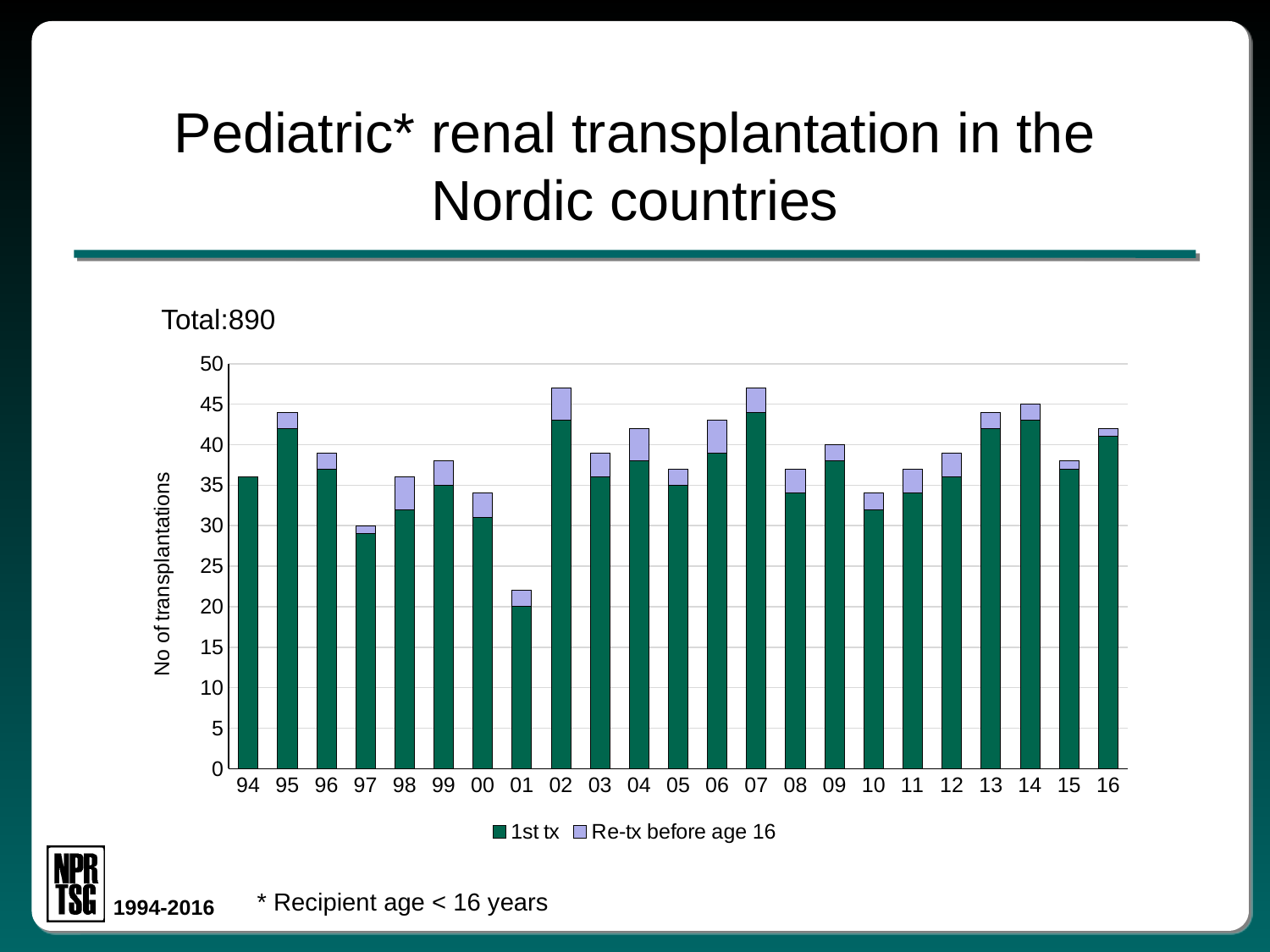
What are the two series named in the legend? 1st tx and Re-tx before age 16 Which year has the lowest total number of transplantations? 01 What total number of transplantations is printed above the chart? Total:890 Is the total value for 01 greater or less than 25? less Is the total value for 02 greater or less than 45? greater Is the total value for 16 greater or less than 40? greater What kind of chart is shown on the slide? bar chart How many series does the legend list? 2 How many years (categories) are shown on the x axis? 23 Which year has the larger total number of transplantations, 97 or 95? 95